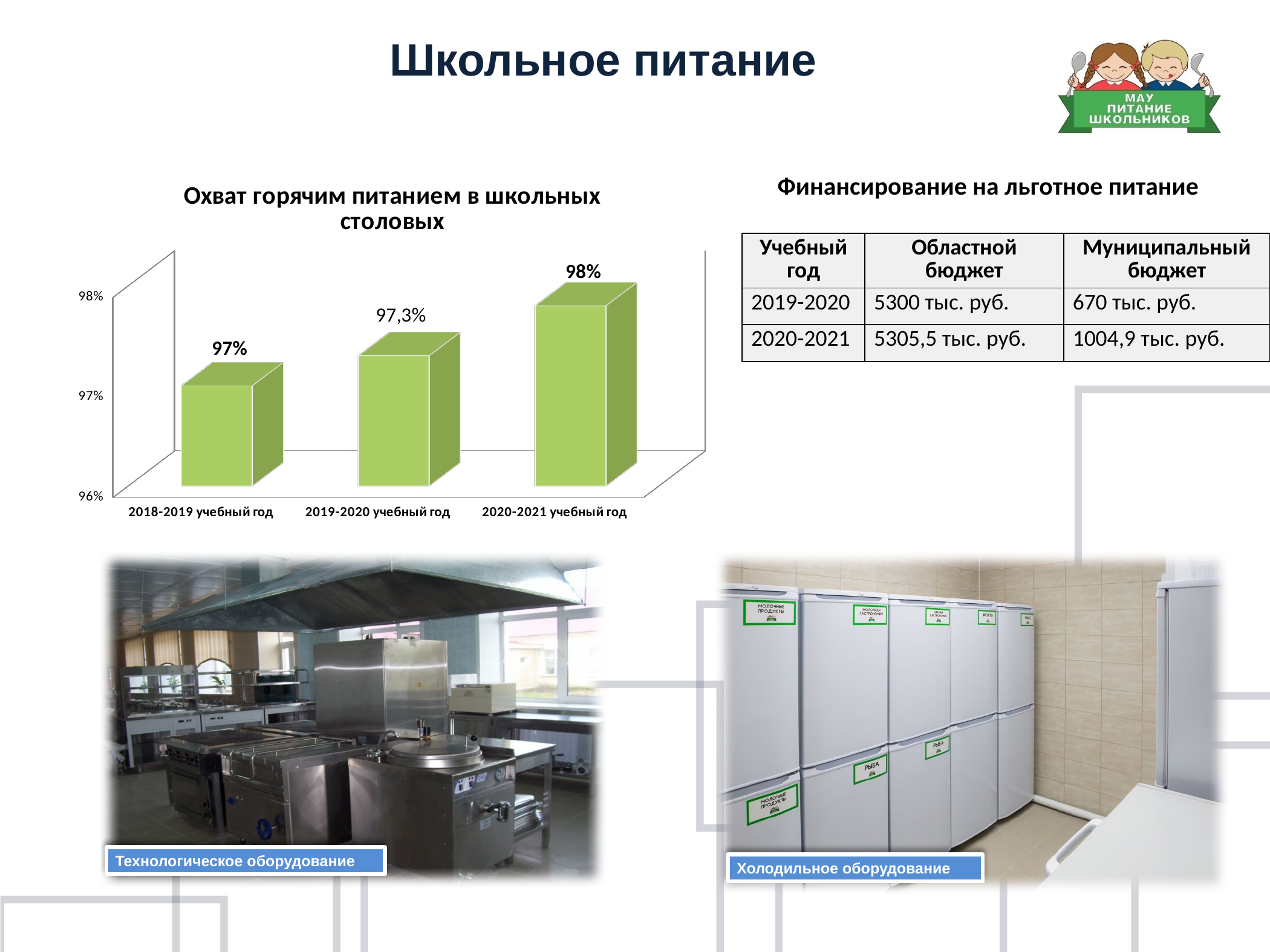
What colour are the bars in the chart "Охват горячим питанием в школьных столовых"? Green In the chart "Охват горячим питанием в школьных столовых", what is the difference between the values for 2020-2021 учебный год and 2018-2019 учебный год? 1% What kind of chart is "Охват горячим питанием в школьных столовых"? Bar chart Do the values in the chart "Охват горячим питанием в школьных столовых" rise or fall from 2018-2019 to 2020-2021? Rise In the chart "Охват горячим питанием в школьных столовых", which is larger: the value for 2019-2020 учебный год or for 2018-2019 учебный год? 2019-2020 учебный год How many school years are shown in the chart "Охват горячим питанием в школьных столовых"? 3 What is the value for 2019-2020 учебный год in the chart "Охват горячим питанием в школьных столовых"? 97,3% What is the value for 2020-2021 учебный год in the chart "Охват горячим питанием в школьных столовых"? 98% What is the value for 2018-2019 учебный год in the chart "Охват горячим питанием в школьных столовых"? 97% Which school year has the lowest value in the chart "Охват горячим питанием в школьных столовых"? 2018-2019 учебный год What is the title of the bar chart on the slide? Охват горячим питанием в школьных столовых Which school year has the highest value in the chart "Охват горячим питанием в школьных столовых"? 2020-2021 учебный год